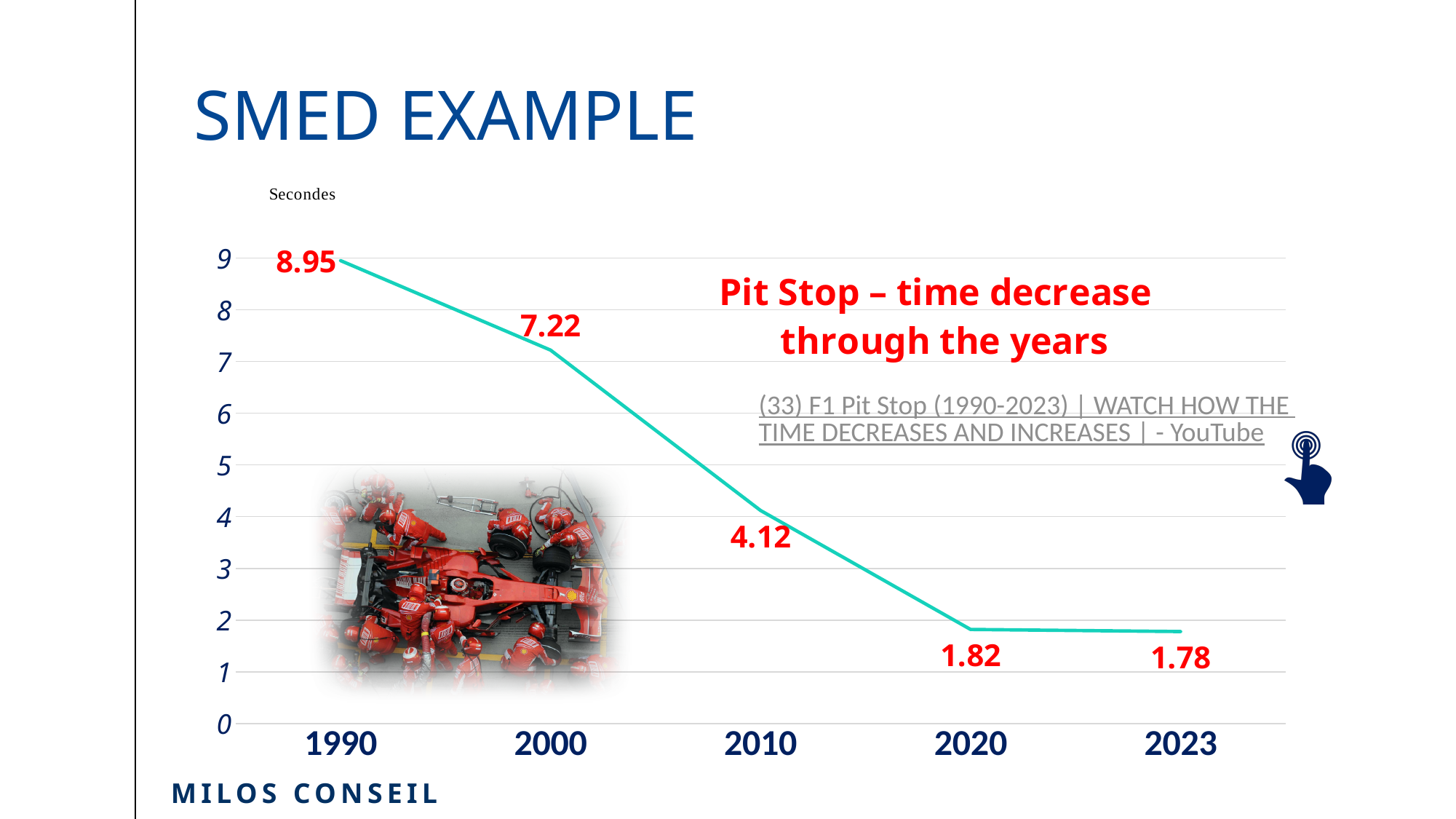
Which year has a larger pit stop time, 2000 or 2010? 2000 Do the pit stop times rise or fall from 1990 to 2023? fall What is the pit stop time shown for 1990? 8.95 What is the pit stop time shown for 2023? 1.78 How many years are plotted on the x axis? 5 What is the difference between the pit stop times for 2010 and 2020? 2.30 Which year has the highest pit stop time? 1990 What kind of chart is shown on the slide? line chart What is the pit stop time shown for 2010? 4.12 Which year has the lowest pit stop time? 2023 What is the difference between the pit stop times for 1990 and 2000? 1.73 What unit is given for the vertical axis of the chart? Secondes